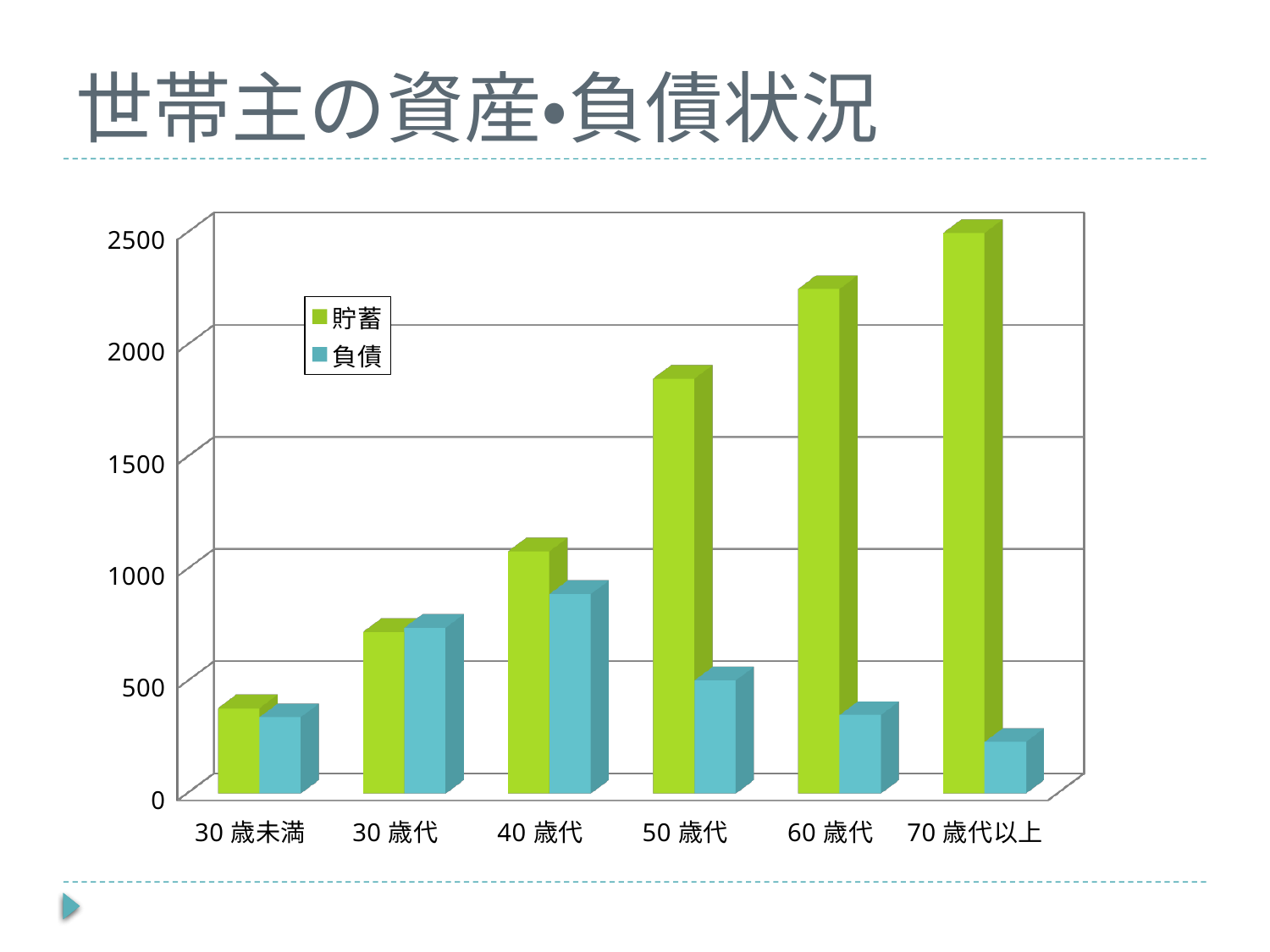
For 50 歳代, which is larger, 貯蓄 or 負債? 貯蓄 Which age category has the highest 負債 value? 40 歳代 Is the 貯蓄 value for 70 歳代以上 greater or less than 2000? greater How many series does the legend list? 2 Which age category has the highest 貯蓄 value? 70 歳代以上 Is the 貯蓄 value for 30 歳未満 greater or less than 500? less How many age categories are shown on the x axis? 6 What kind of chart is shown on the slide? bar chart Which age category has the lowest 負債 value? 70 歳代以上 Which age category has the lowest 貯蓄 value? 30 歳未満 Do the 貯蓄 values rise or fall as the age categories move from left to right? rise Is the 負債 value for 40 歳代 greater or less than 500? greater